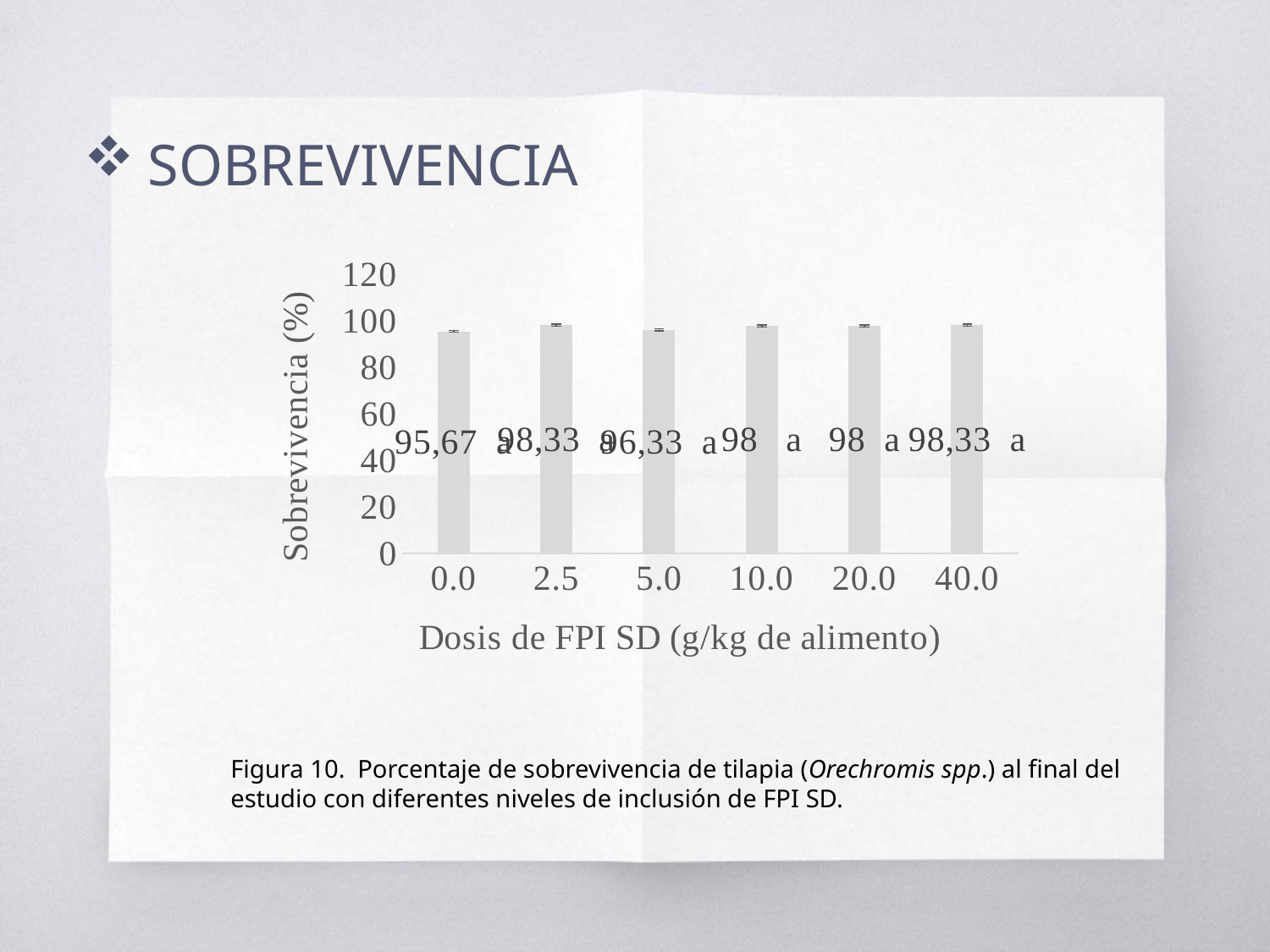
Is the survival value for the 20.0 g/kg dose greater or less than 80? greater Which dose has the lowest survival percentage? 0.0 What is the label of the x axis? Dosis de FPI SD (g/kg de alimento) What is the survival percentage for the 40.0 g/kg dose? 98,33 How many dose categories are shown on the x axis? 6 What is the survival percentage for the 5.0 g/kg dose? 96,33 What is the survival percentage for the 2.5 g/kg dose? 98,33 Which dose has a higher survival percentage, 5.0 or 10.0 g/kg? 10.0 What is the survival percentage for the 10.0 g/kg dose? 98 What type of chart is shown on the slide? bar chart What is the survival percentage for the 0.0 g/kg dose? 95,67 What is the difference in survival percentage between the 2.5 and 0.0 g/kg doses? 2,66